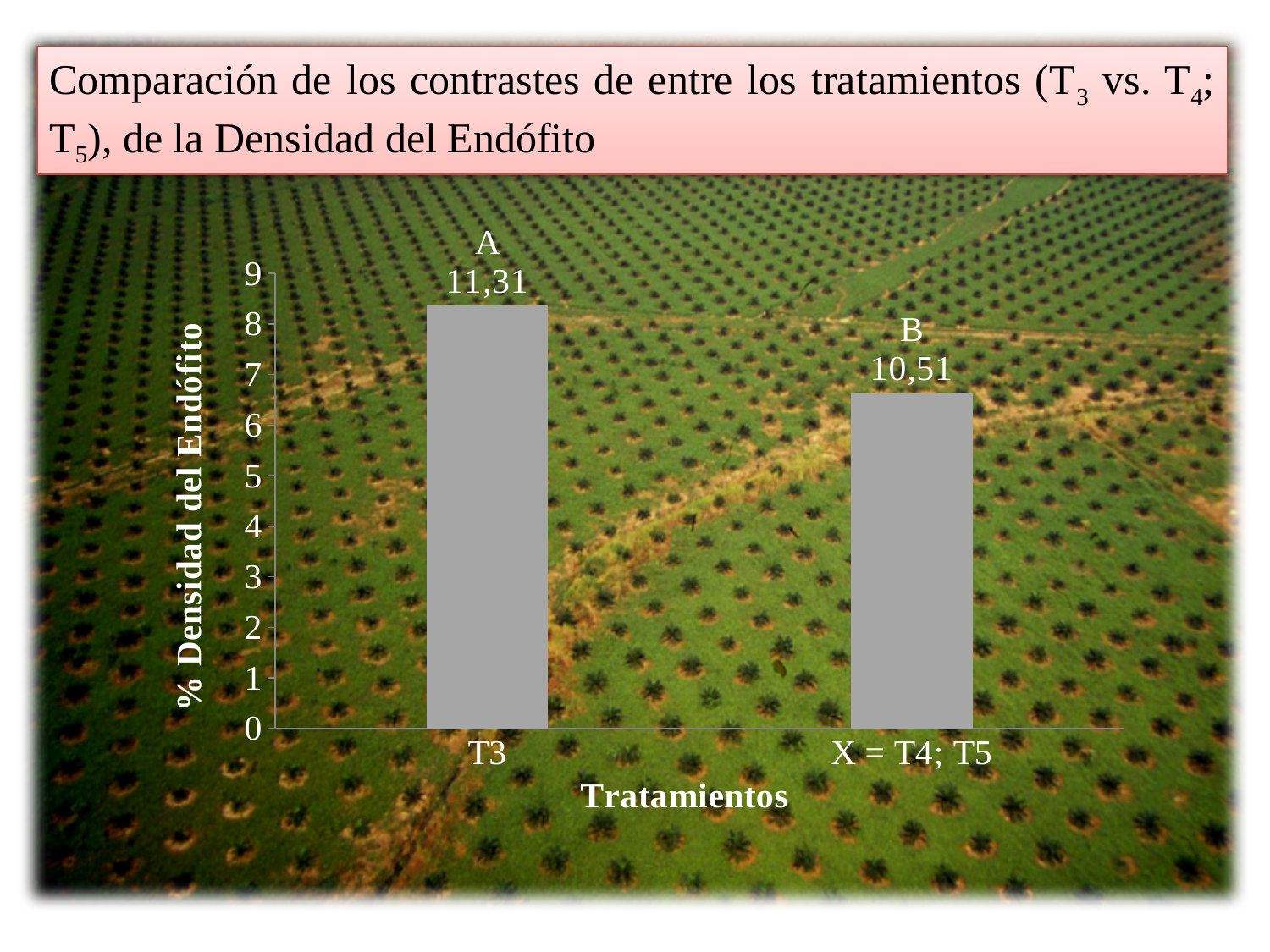
What is the difference between the labelled values for T3 and X = T4; T5? 0,80 Is the bar for X = T4; T5 greater or less than 7 on the y axis? less What value is labelled on the bar for T3? 11,31 Which bar is taller, T3 or X = T4; T5? T3 Is the bar for T3 greater or less than 7 on the y axis? greater What letter is printed above the bar for X = T4; T5? B What value is labelled on the bar for X = T4; T5? 10,51 Which treatment has the highest bar? T3 How many bars (categories) does the chart show? 2 Which treatment has the lowest bar? X = T4; T5 What kind of chart is shown on the slide? bar chart What is the title of the x axis? Tratamientos